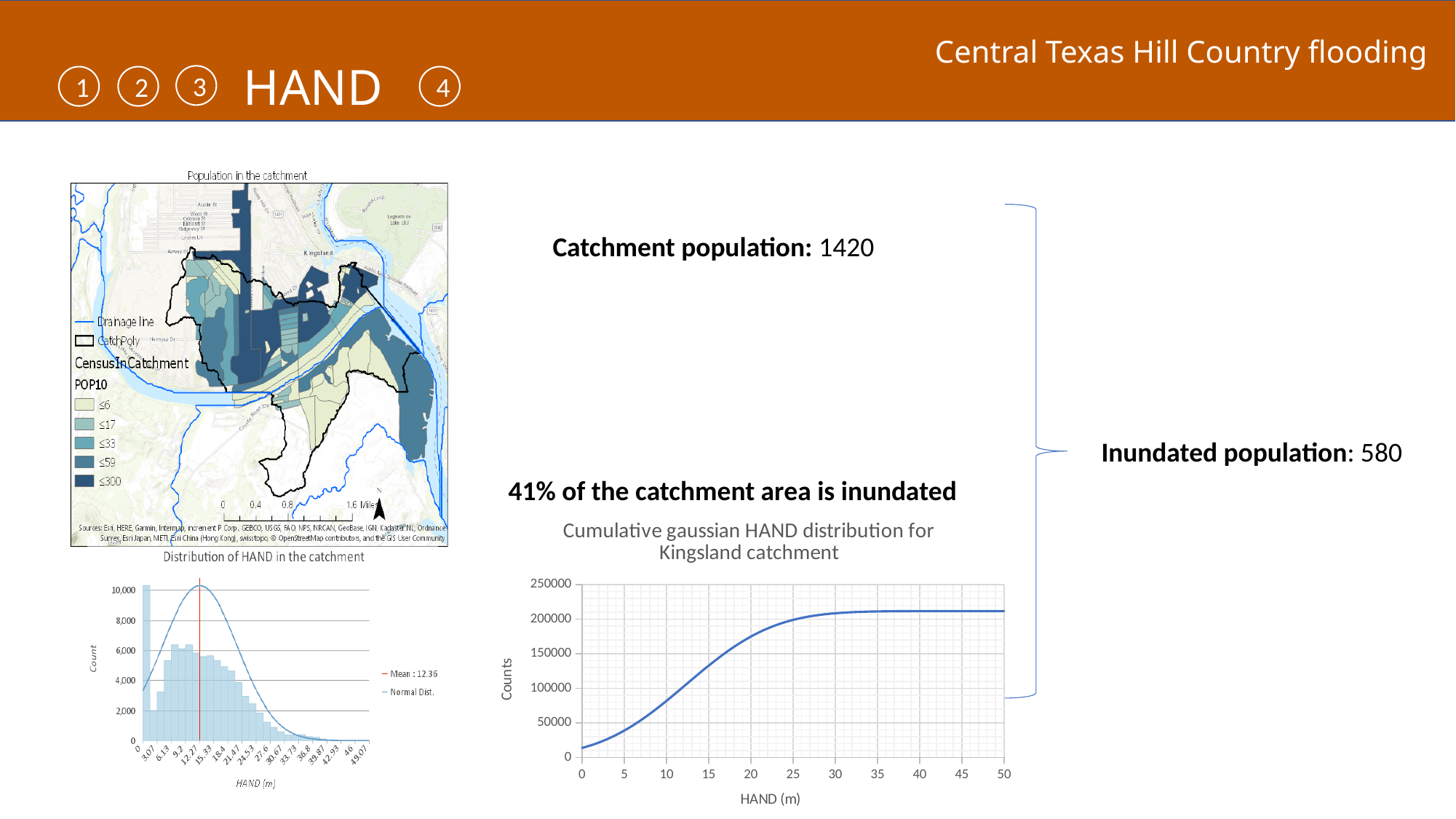
What is the label of the y axis of the 'Cumulative gaussian HAND distribution for Kingsland catchment' chart? Counts How many entries does the legend of the 'Distribution of HAND in the catchment' chart list? 2 In the 'Cumulative gaussian HAND distribution for Kingsland catchment' chart, is the count at HAND 20 m greater or less than 150000? greater In the 'Distribution of HAND in the catchment' chart, is the count of the tallest bar greater or less than 8,000? greater In the 'Distribution of HAND in the catchment' chart, what mean value is shown in the legend? 12.36 In the 'Cumulative gaussian HAND distribution for Kingsland catchment' chart, is the count at HAND 30 m greater or less than 200000? greater What is the label of the x axis of the 'Cumulative gaussian HAND distribution for Kingsland catchment' chart? HAND (m) What type of chart is the 'Distribution of HAND in the catchment' chart? bar chart What type of chart is the 'Cumulative gaussian HAND distribution for Kingsland catchment' chart? line chart In the 'Cumulative gaussian HAND distribution for Kingsland catchment' chart, do the counts rise or fall as HAND increases along the x axis? rise